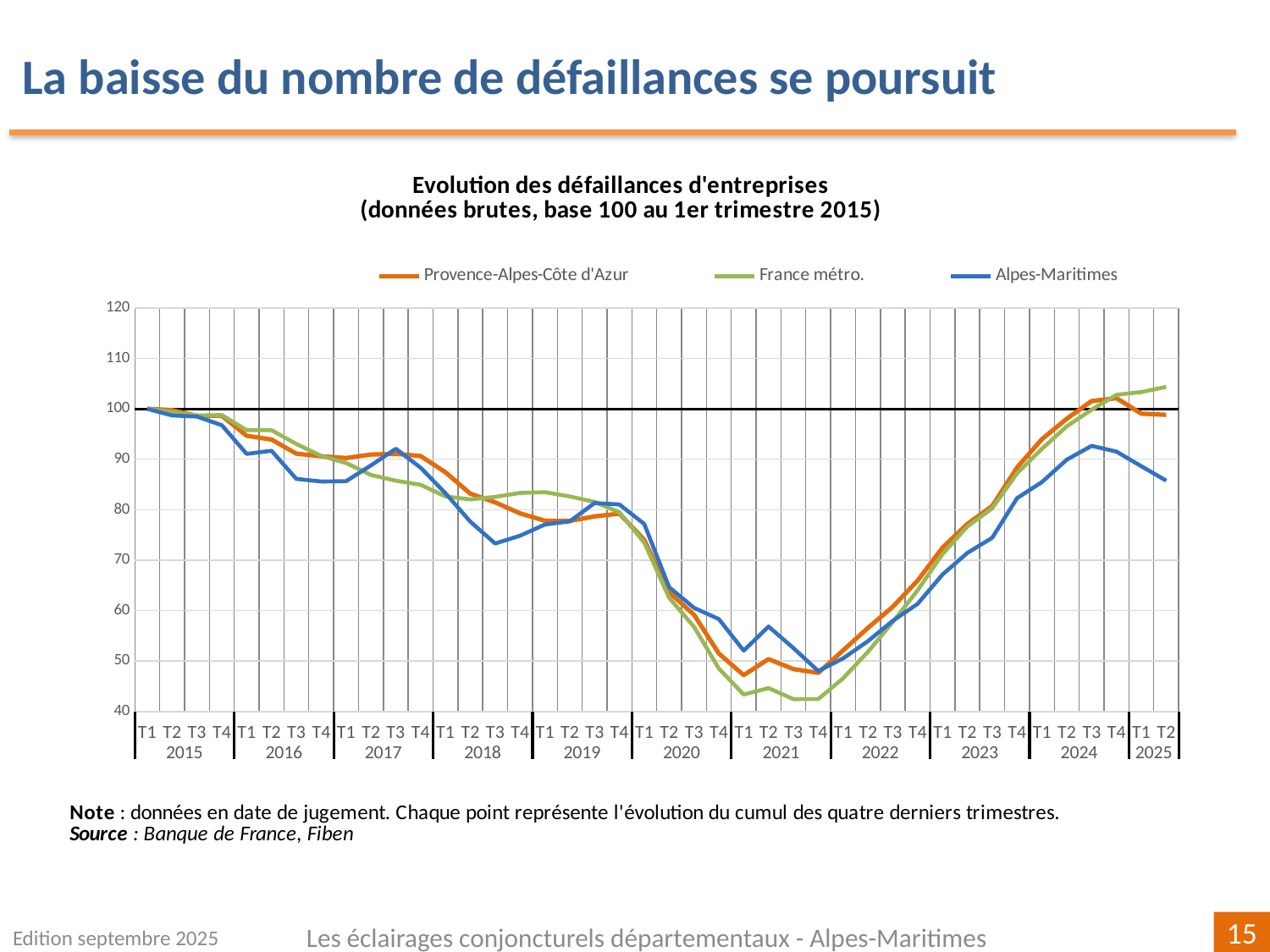
How many series does the legend list? 3 Do the values for Provence-Alpes-Côte d'Azur rise or fall from T1 2022 to T3 2024? rise What kind of chart is shown on the slide? line chart What is the value of all three series at T1 2015? 100 Which colour is used for the Alpes-Maritimes line? blue Is the value for Alpes-Maritimes at T4 2018 greater or less than 80? less Is the value for France métro. at T3 2021 greater or less than 50? less Is the value for Alpes-Maritimes at T2 2025 greater or less than 90? less Which series has the lowest value at T3 2021? France métro. At T2 2025, which is larger: Alpes-Maritimes or Provence-Alpes-Côte d'Azur? Provence-Alpes-Côte d'Azur Which series has the highest value at T2 2025? France métro.